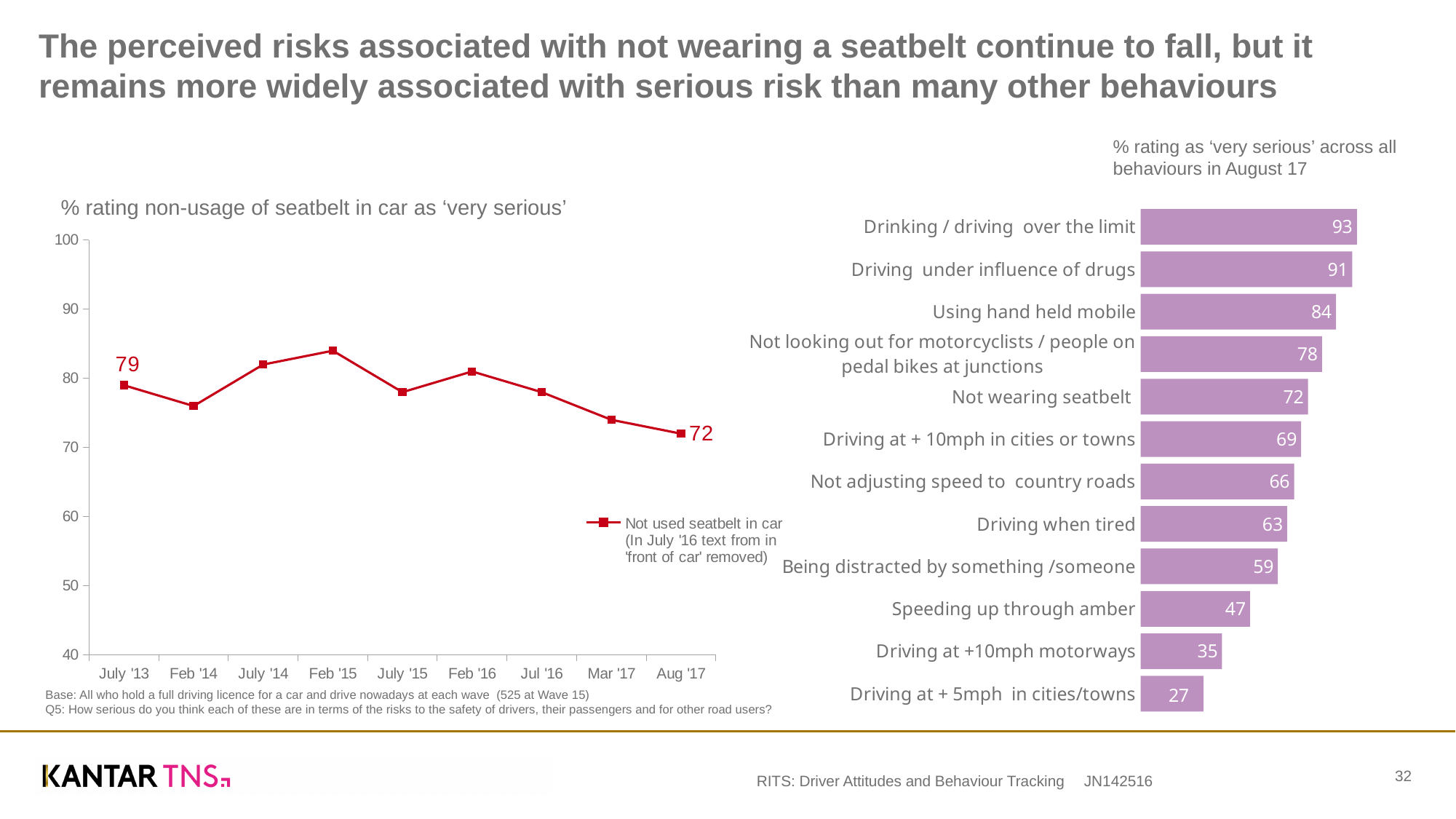
In the chart '% rating as ‘very serious’ across all behaviours in August 17', which is larger: Speeding up through amber or Driving at +10mph motorways? Speeding up through amber In the chart '% rating non-usage of seatbelt in car as ‘very serious’', is the value for Feb '15 greater or less than 80? greater In the chart '% rating as ‘very serious’ across all behaviours in August 17', what is the difference between Not wearing seatbelt and Driving when tired? 9 What kind of chart is the left-hand chart on the slide? Line chart In the chart '% rating as ‘very serious’ across all behaviours in August 17', which behaviour has the highest value? Drinking / driving over the limit In the chart '% rating as ‘very serious’ across all behaviours in August 17', how many behaviours are shown? 12 In the chart '% rating as ‘very serious’ across all behaviours in August 17', what is the value for Using hand held mobile? 84 In the chart '% rating as ‘very serious’ across all behaviours in August 17', which behaviour has the lowest value? Driving at + 5mph in cities/towns In the chart '% rating non-usage of seatbelt in car as ‘very serious’', what is the value for Aug '17? 72 In the chart '% rating non-usage of seatbelt in car as ‘very serious’', by how much did the value fall from July '13 to Aug '17? 7 In the chart '% rating non-usage of seatbelt in car as ‘very serious’', how many time points are plotted? 9 In the chart '% rating non-usage of seatbelt in car as ‘very serious’', what is the value for July '13? 79